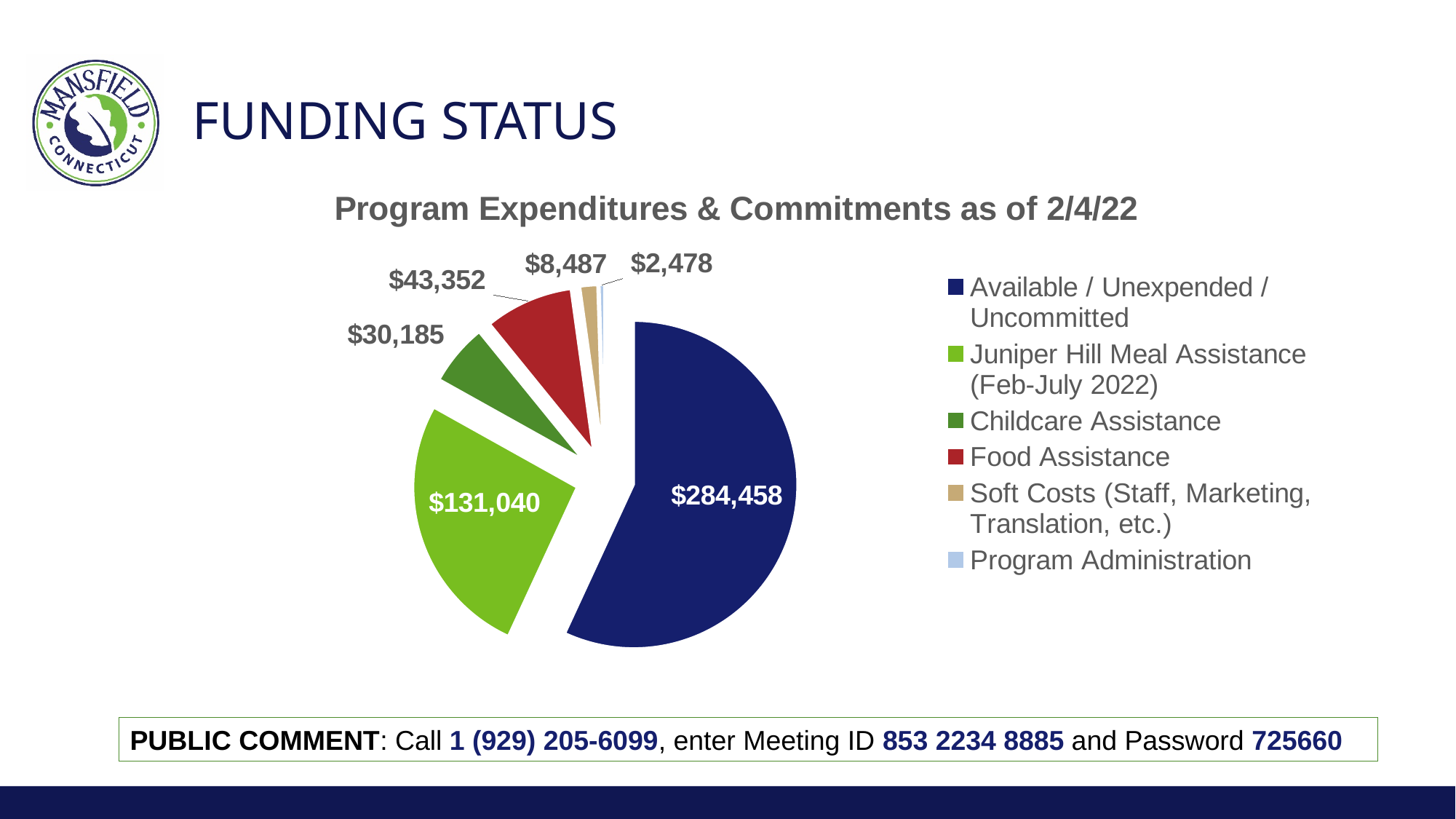
What is the value for Food Assistance? $43,352 What is the value for Childcare Assistance? $30,185 What is the value for Juniper Hill Meal Assistance (Feb-July 2022)? $131,040 Which is larger, Soft Costs (Staff, Marketing, Translation, etc.) or Program Administration? Soft Costs (Staff, Marketing, Translation, etc.) Which category has the largest slice of the pie? Available / Unexpended / Uncommitted What is the title of the chart? Program Expenditures & Commitments as of 2/4/22 What is the value for Available / Unexpended / Uncommitted? $284,458 What is the value for Program Administration? $2,478 How many categories does the pie chart show? 6 What kind of chart is shown on the slide? Pie chart What is the difference between Food Assistance and Childcare Assistance? $13,167 Which category has the smallest slice of the pie? Program Administration